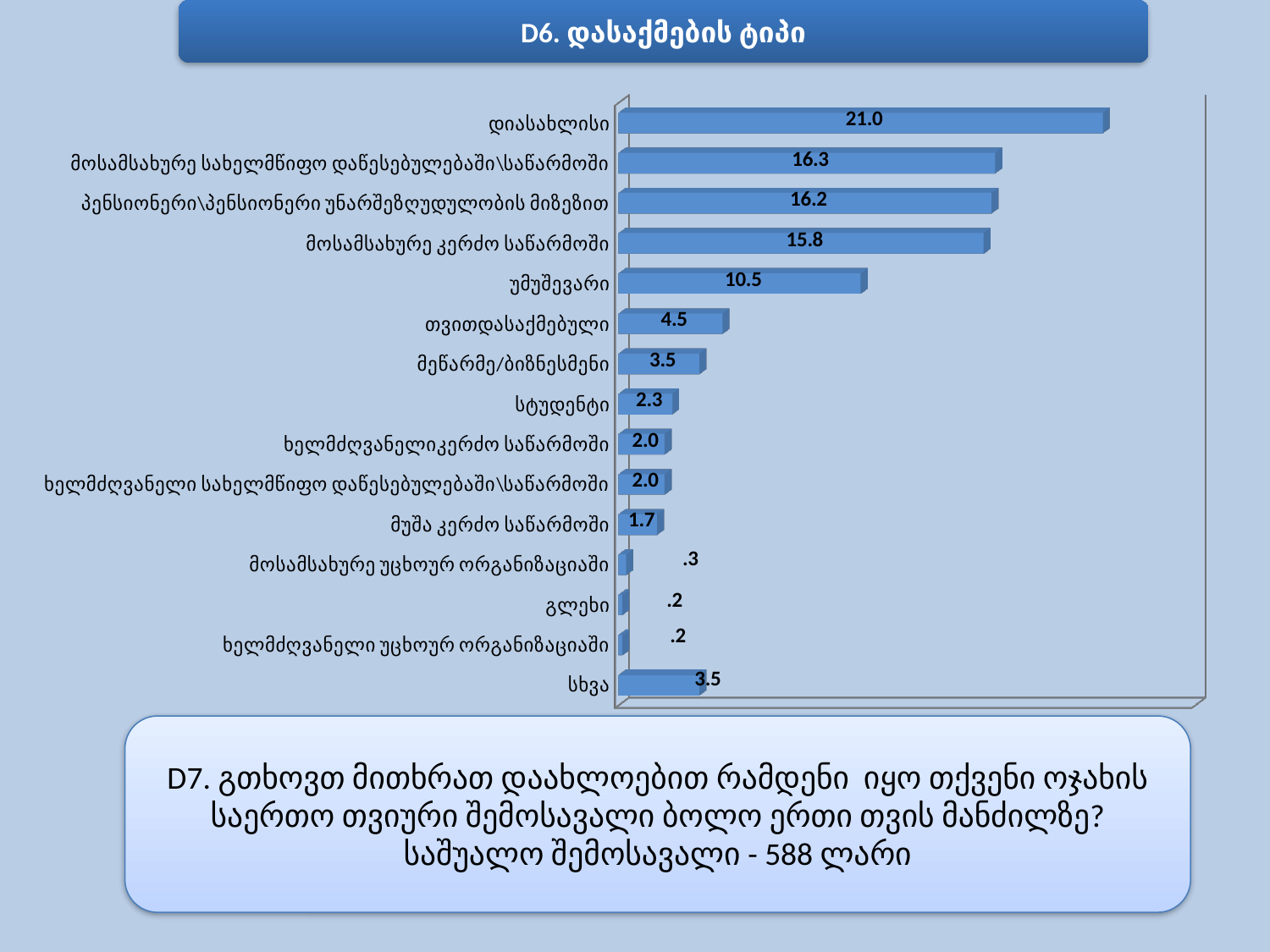
What kind of chart is shown on the slide? Bar chart What is the difference between the values for თვითდასაქმებული and სტუდენტი? 2.2 What is the value for სტუდენტი? 2.3 How many categories are shown in the chart? 15 What is the value for დიასახლისი? 21.0 Which category has the highest value? დიასახლისი What is the title of the chart? D6. დასაქმების ტიპი What is the value for გლეხი? .2 Which is larger, the value for მოსამსახურე კერძო საწარმოში or the value for უმუშევარი? მოსამსახურე კერძო საწარმოში Which is larger, the value for მუშა კერძო საწარმოში or the value for სხვა? სხვა What is the difference between the values for დიასახლისი and უმუშევარი? 10.5 What is the value for უმუშევარი? 10.5